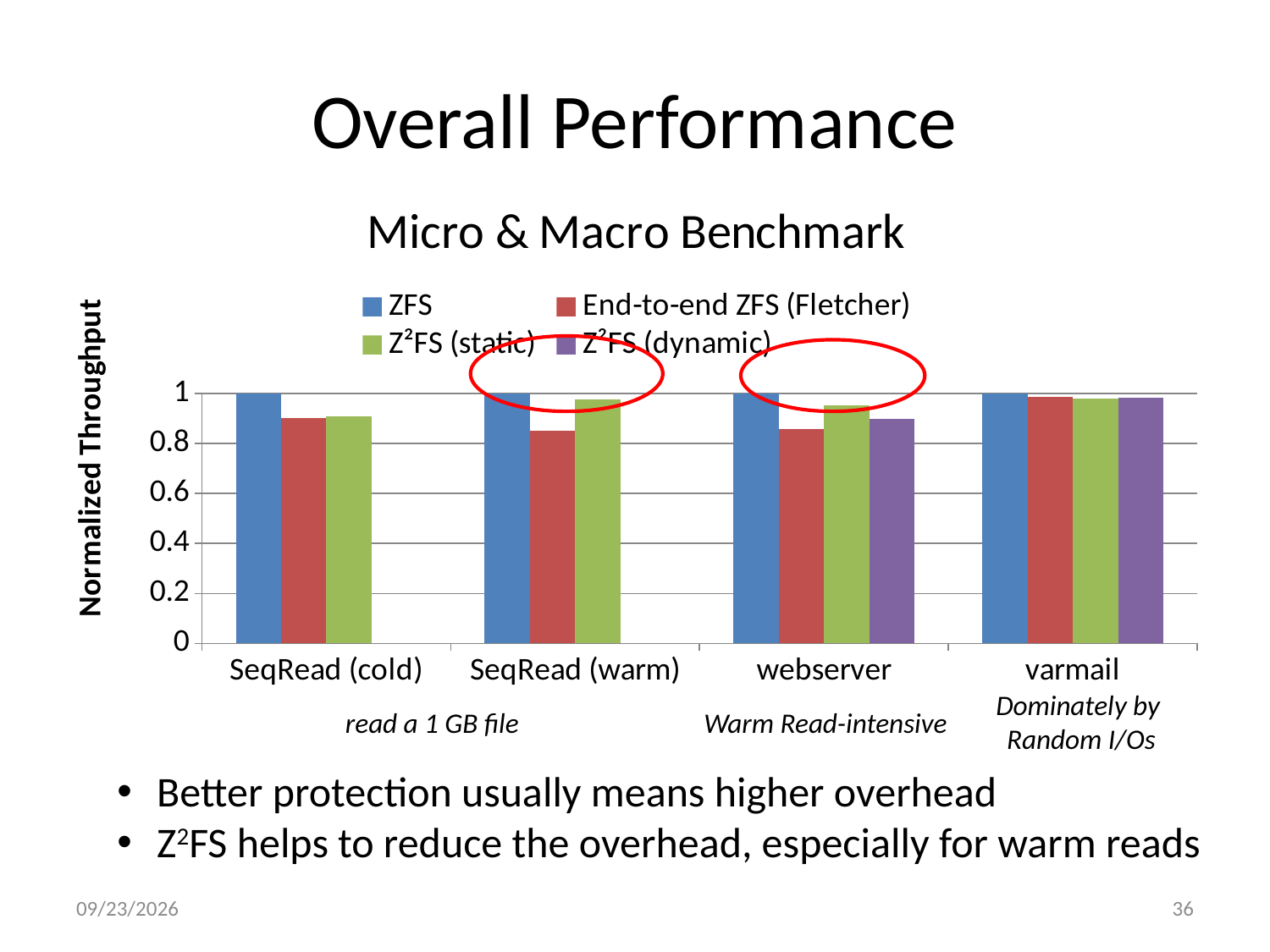
How many categories include a Z²FS (dynamic) bar? 2 What is the value of the ZFS bar for SeqRead (warm)? 1 What is the label of the y axis? Normalized Throughput Is the value for Z²FS (dynamic) in webserver greater or less than 0.8? greater What is the value of the ZFS bar for varmail? 1 What is the title of the chart? Micro & Macro Benchmark How many categories are shown on the x axis of the chart? 4 How many series does the chart's legend list? 4 For webserver, which is larger: End-to-end ZFS (Fletcher) or Z²FS (static)? Z²FS (static) Which series has the lowest value for SeqRead (warm)? End-to-end ZFS (Fletcher) Is the value for End-to-end ZFS (Fletcher) in SeqRead (warm) greater or less than 1? less What kind of chart is shown on the slide? bar chart